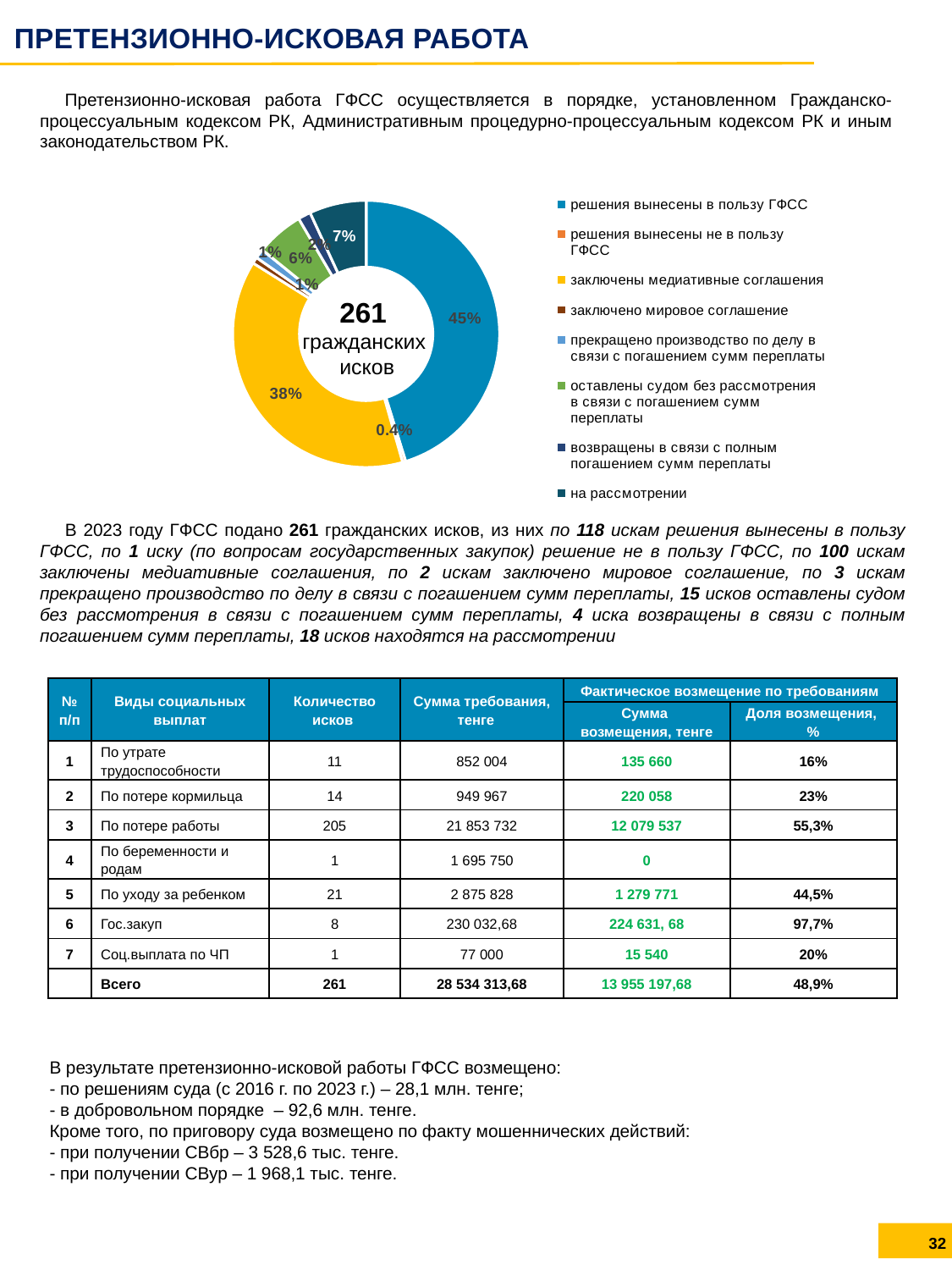
Which slice is larger in the pie chart: 'заключены медиативные соглашения' or 'на рассмотрении'? заключены медиативные соглашения What share of the pie chart is labelled for 'решения вынесены в пользу ГФСС'? 45% Which category has the smallest slice in the pie chart? решения вынесены не в пользу ГФСС What share of the pie chart is labelled for 'оставлены судом без рассмотрения в связи с погашением сумм переплаты'? 6% Which category has the largest slice in the pie chart? решения вынесены в пользу ГФСС What share of the pie chart is labelled for 'решения вынесены не в пользу ГФСС'? 0.4% What number is shown in the centre of the pie chart? 261 What share of the pie chart is labelled for 'на рассмотрении'? 7% How many categories does the legend of the pie chart list? 8 What kind of chart is shown on the slide? pie chart (doughnut) By how many percentage points does the 'решения вынесены в пользу ГФСС' slice exceed the 'заключены медиативные соглашения' slice? 7 percentage points What share of the pie chart is labelled for 'заключены медиативные соглашения'? 38%